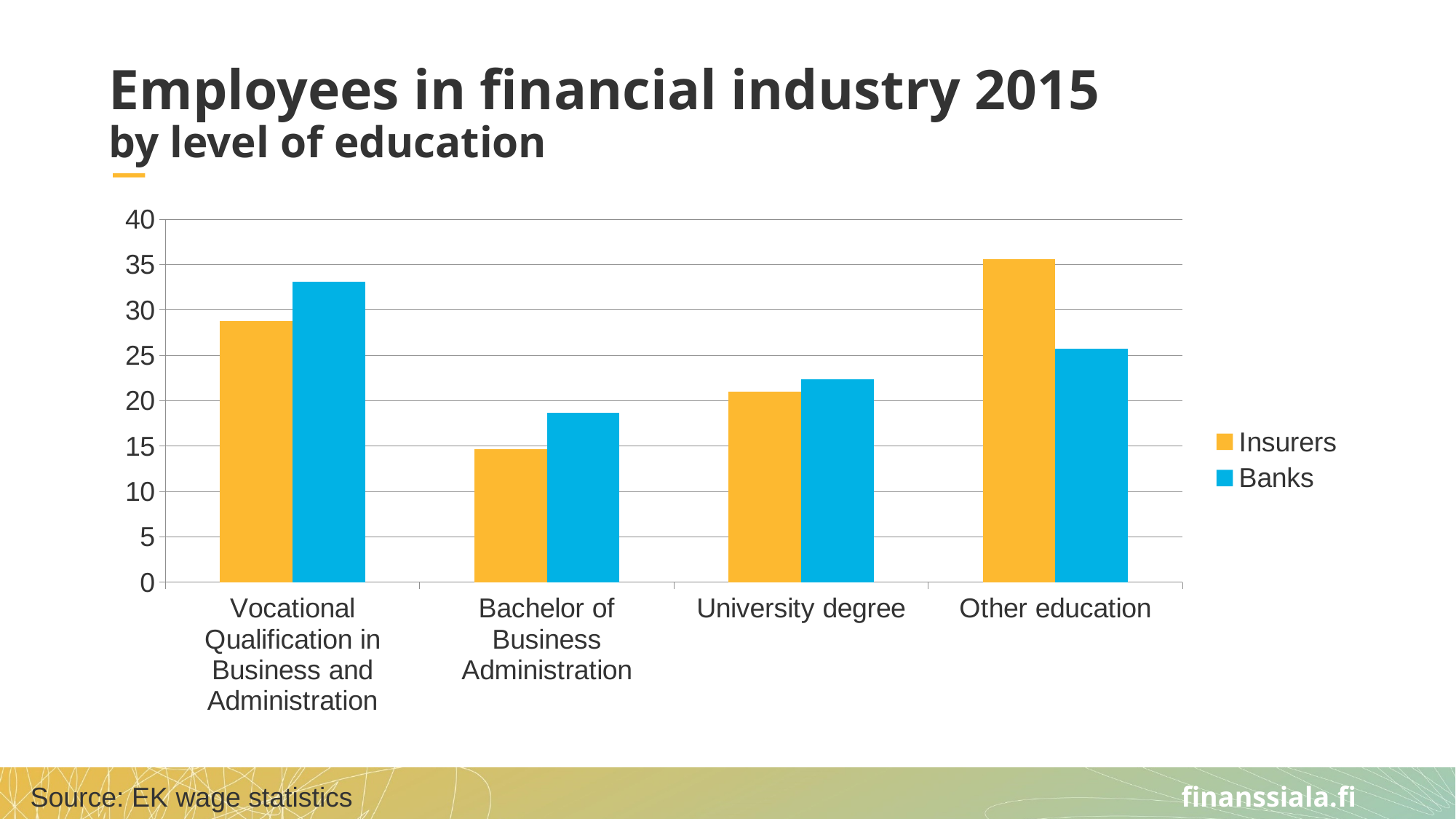
Is the Banks value for Bachelor of Business Administration greater or less than 20? less For which education category is the Insurers value highest? Other education Is the Banks value for Vocational Qualification in Business and Administration greater or less than 30? greater For Vocational Qualification in Business and Administration, which is larger, the Insurers value or the Banks value? Banks For which education category is the Banks value highest? Vocational Qualification in Business and Administration What kind of chart is shown on the slide? bar chart For Other education, which is larger, the Insurers value or the Banks value? Insurers How many series does the legend list? 2 Which series is shown in blue in the legend? Banks For which education category is the Banks value lowest? Bachelor of Business Administration How many education categories are shown on the x axis? 4 For which education category is the Insurers value lowest? Bachelor of Business Administration